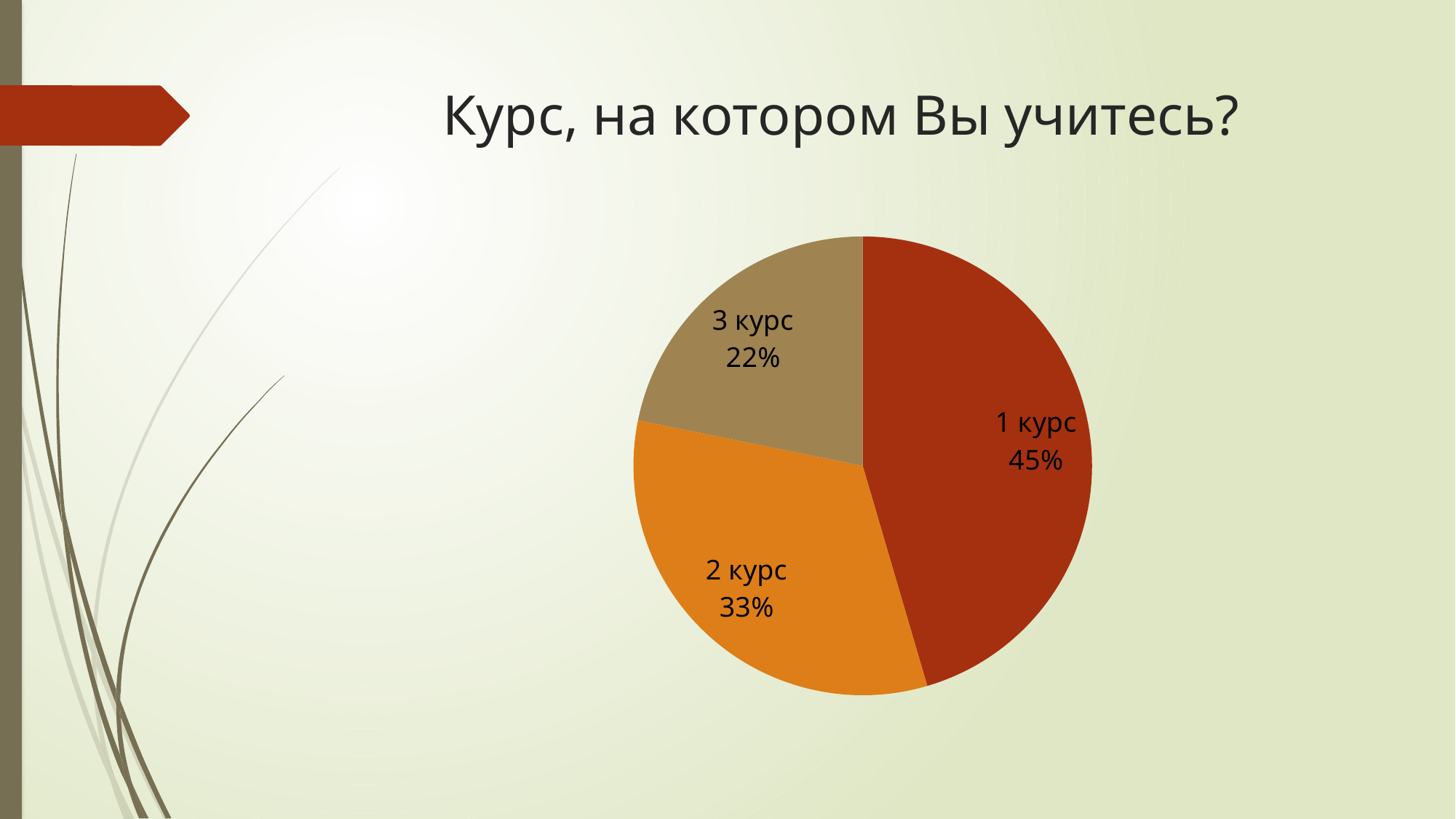
What share of the pie does "2 курс" have? 33% Which is larger, the slice for "2 курс" or the slice for "3 курс"? 2 курс What colour is the slice for "2 курс"? orange What share of the pie does "3 курс" have? 22% What is the difference in percentage points between "1 курс" and "3 курс"? 23 What is the title of the slide? Курс, на котором Вы учитесь? What share of the pie does "1 курс" have? 45% What kind of chart is shown on the slide? pie chart Which category has the smallest slice of the pie? 3 курс What is the difference in percentage points between "2 курс" and "3 курс"? 11 How many categories are shown in the pie chart? 3 Which category has the largest slice of the pie? 1 курс